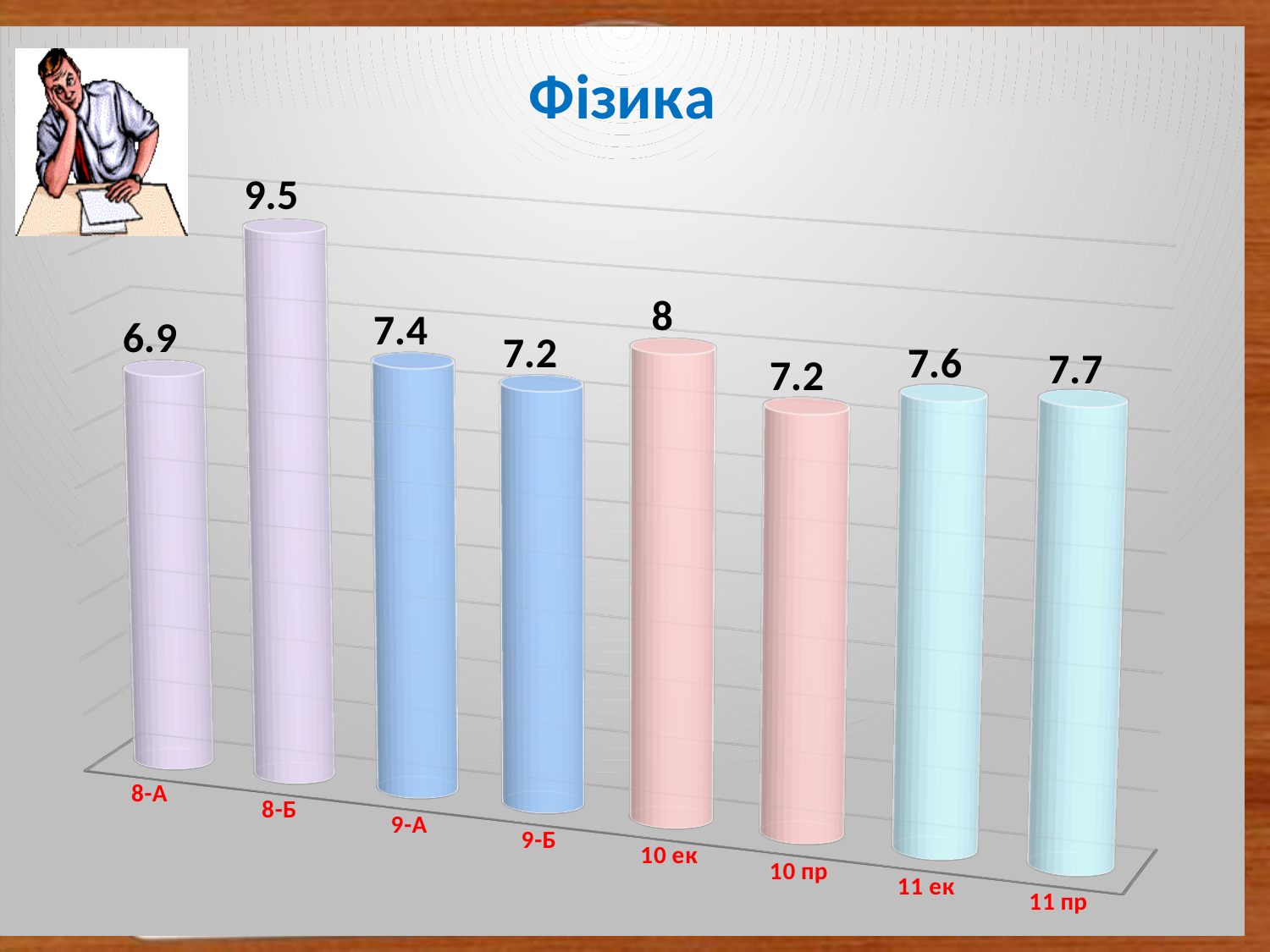
What is the value for 9-А? 7.4 What is the difference between the values for 8-Б and 8-А? 2.6 How many categories are shown in the chart? 8 Which category has the lowest value? 8-А What is the value for 10 ек? 8 Which category has the highest value? 8-Б What kind of chart is this? bar chart What is the value for 8-Б? 9.5 Which is larger, the value for 11 ек or the value for 9-Б? 11 ек What is the value for 11 пр? 7.7 What is the title of the chart? Фізика What is the difference between the values for 10 ек and 10 пр? 0.8